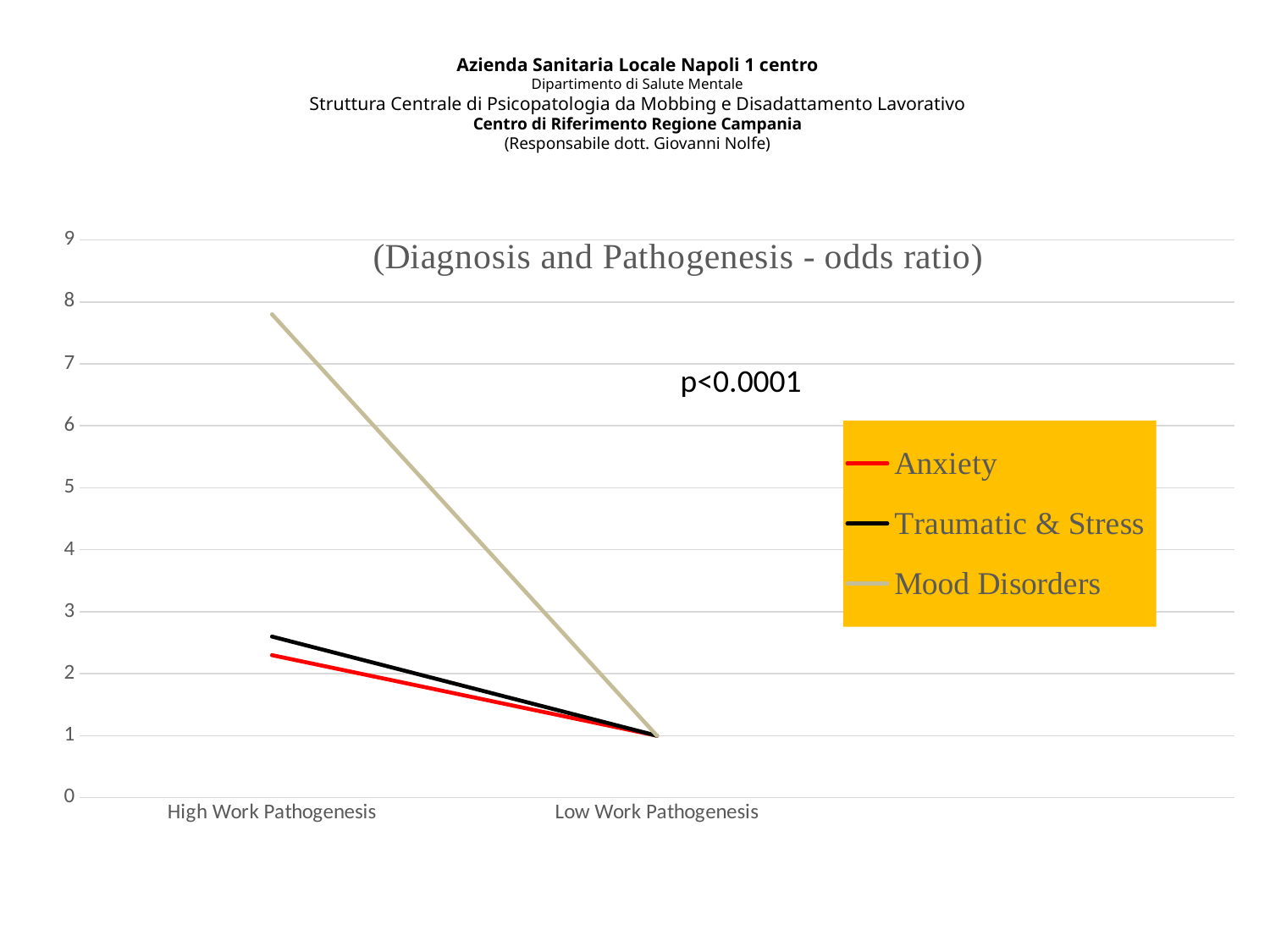
What is the title of the chart? (Diagnosis and Pathogenesis - odds ratio) How many series does the chart legend list? 3 Is the value for Traumatic & Stress at High Work Pathogenesis greater or less than 2? greater Is the value for Anxiety at High Work Pathogenesis greater or less than 3? less What kind of chart is shown on the slide? line chart At High Work Pathogenesis, which is larger: Traumatic & Stress or Anxiety? Traumatic & Stress How many categories are shown on the x axis of the chart? 2 Is the value for Mood Disorders at High Work Pathogenesis greater or less than 7? greater Which series has the lowest value at High Work Pathogenesis? Anxiety Do the values for Mood Disorders rise or fall from High Work Pathogenesis to Low Work Pathogenesis? fall What colour is the line for Anxiety in the chart? red Which series has the highest value at High Work Pathogenesis? Mood Disorders